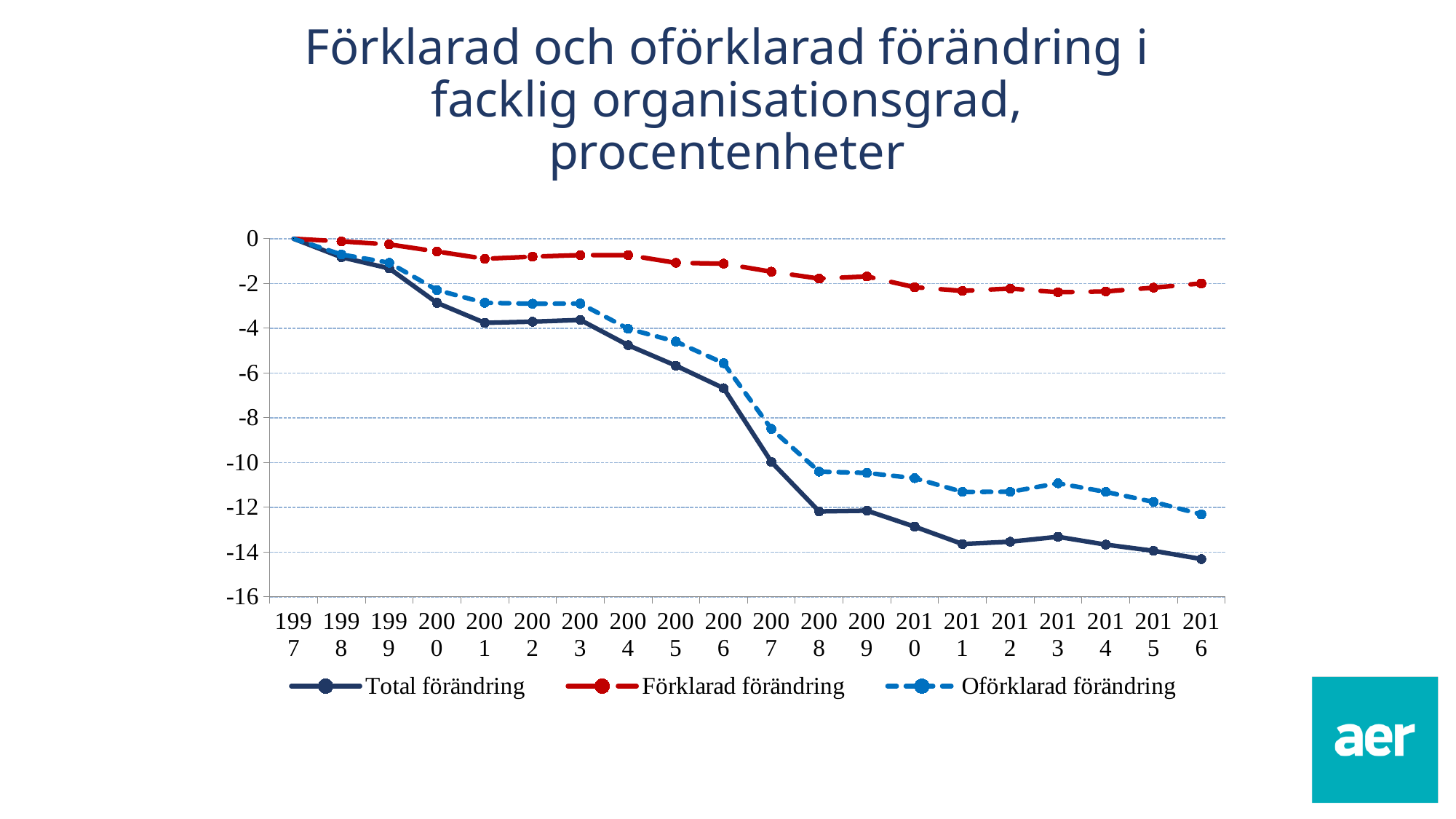
How many years are plotted along the x axis? 20 In which year is Total förändring at its highest? 1997 Does the Total förändring series rise or fall from 1997 to 2016? fall In 2016, which is larger: Förklarad förändring or Oförklarad förändring? Förklarad förändring Which series has the lowest value in 2016? Total förändring Which series is drawn with a red dashed line? Förklarad förändring Is the value for Oförklarad förändring in 2008 greater or less than -10? less What kind of chart is shown on the slide? line chart Is the value for Förklarad förändring in 2005 greater or less than -2? greater How many series does the legend list? 3 Is the value for Total förändring in 2011 greater or less than -12? less